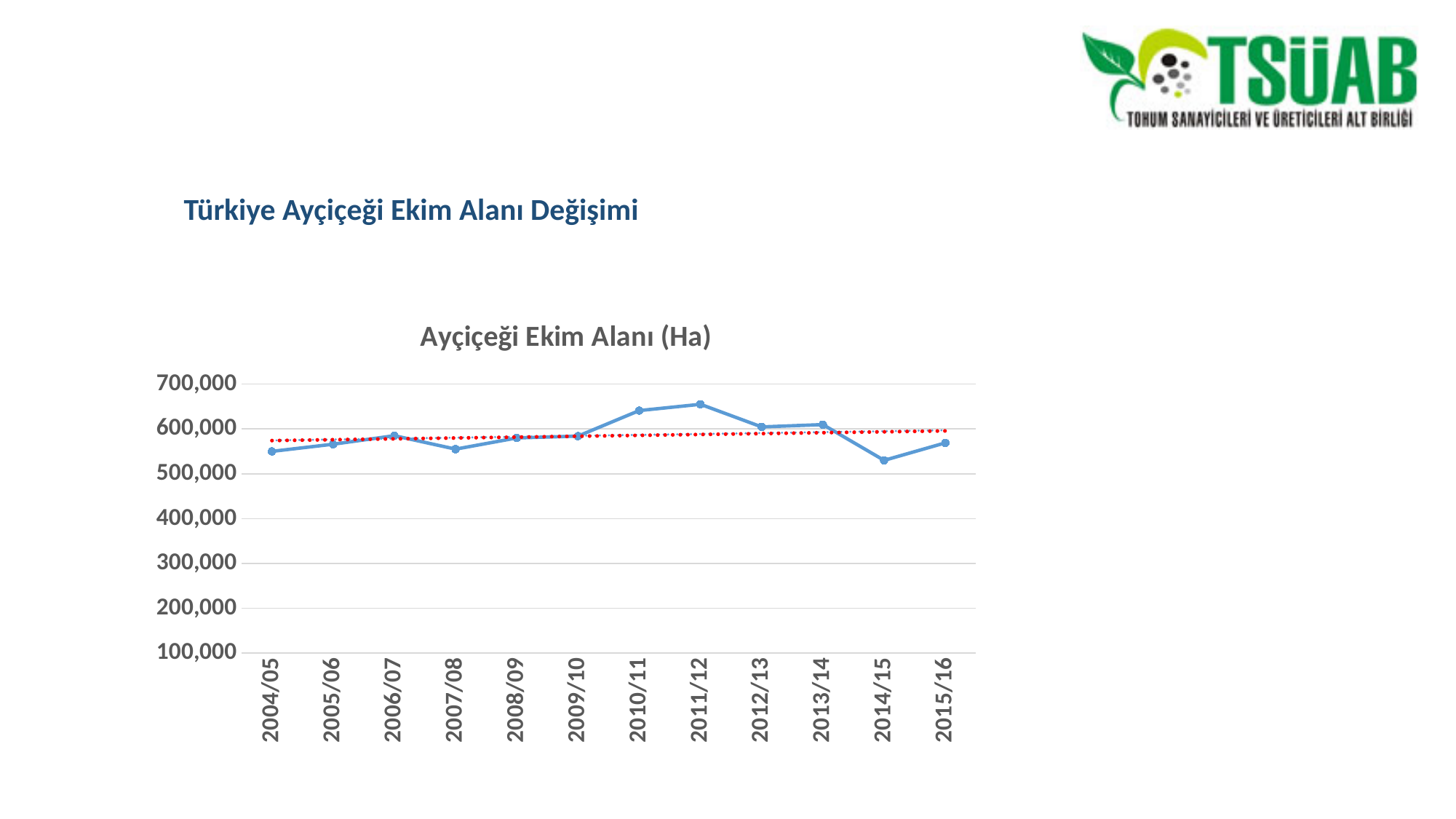
How many seasons are plotted along the x axis? 12 Is the value for 2011/12 greater or less than 600,000? greater Is the value for 2014/15 greater or less than 600,000? less Which is larger, the value for 2010/11 or the value for 2015/16? 2010/11 Is the value for 2004/05 greater or less than 600,000? less Which season has the highest sunflower planting area? 2011/12 What kind of chart is shown on the slide? Line chart Which season has the lowest sunflower planting area? 2014/15 What does the red dotted line on the chart represent? A trend line What is the title of the chart? Ayçiçeği Ekim Alanı (Ha)